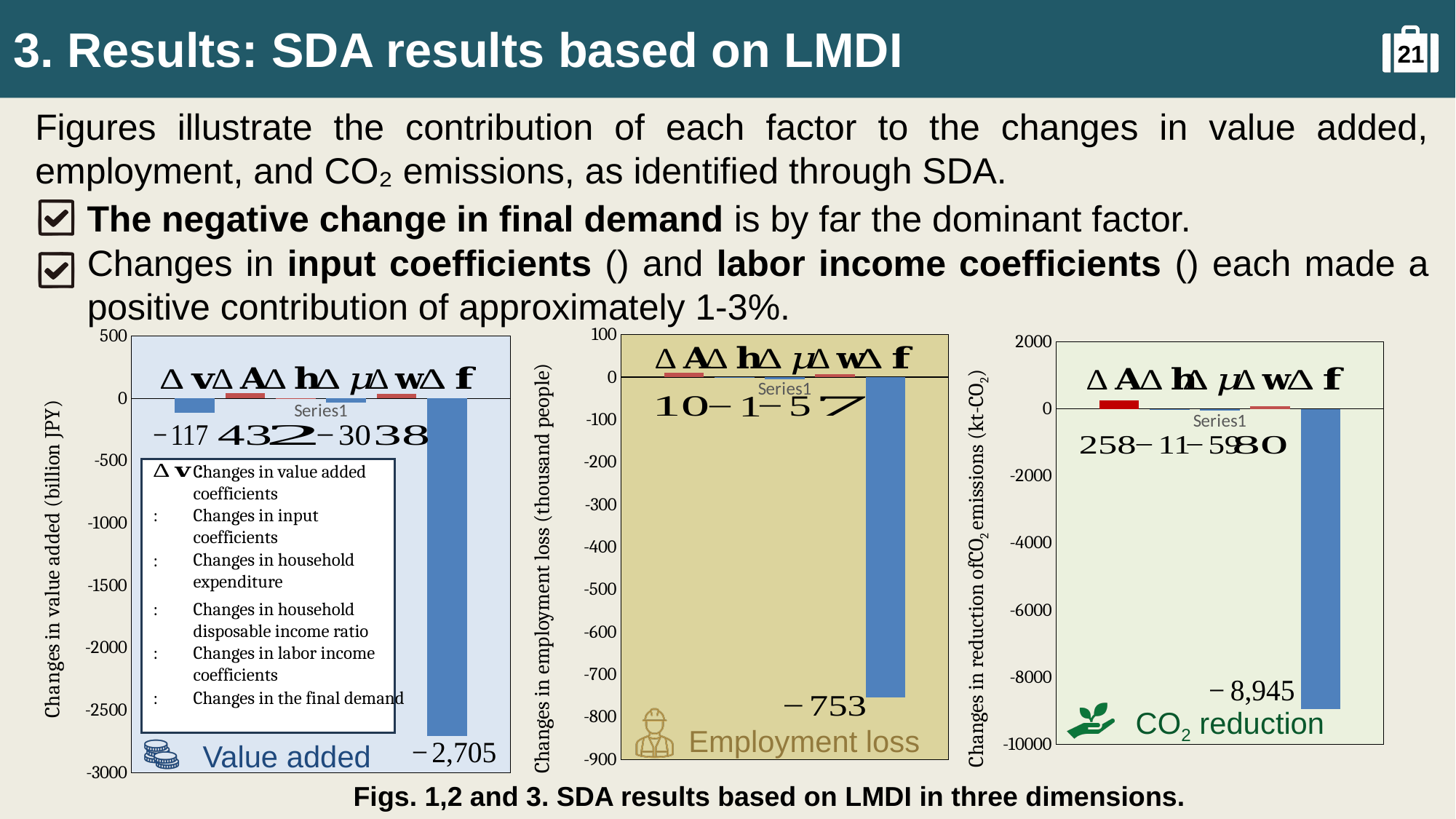
What is the y-axis label of the 'CO2 reduction' chart on the right? Changes in reduction of CO2 emissions (kt-CO2) In the 'CO2 reduction' chart on the right, is the value for Δf greater or less than −8000? less In the 'CO2 reduction' chart on the right, what is the value for the final demand factor (Δf)? −8,945 How many factor categories are plotted in the 'Employment loss' chart in the middle? 5 In the 'Value added' chart on the left, what is the value for the final demand factor (Δf)? −2,705 In the 'Value added' chart on the left, what is the value for Δv? −117 What type of chart is the 'Value added' chart on the left? bar chart In the 'CO2 reduction' chart on the right, which factor has the lowest value? Δf In the 'Value added' chart on the left, which is lower, the value for Δv or the value for Δf? Δf In the 'Employment loss' chart in the middle, is the value for Δf greater or less than −700? less In the 'Value added' chart on the left, which factor has the lowest value? Δf In the 'Employment loss' chart in the middle, what is the value for the final demand factor (Δf)? −753